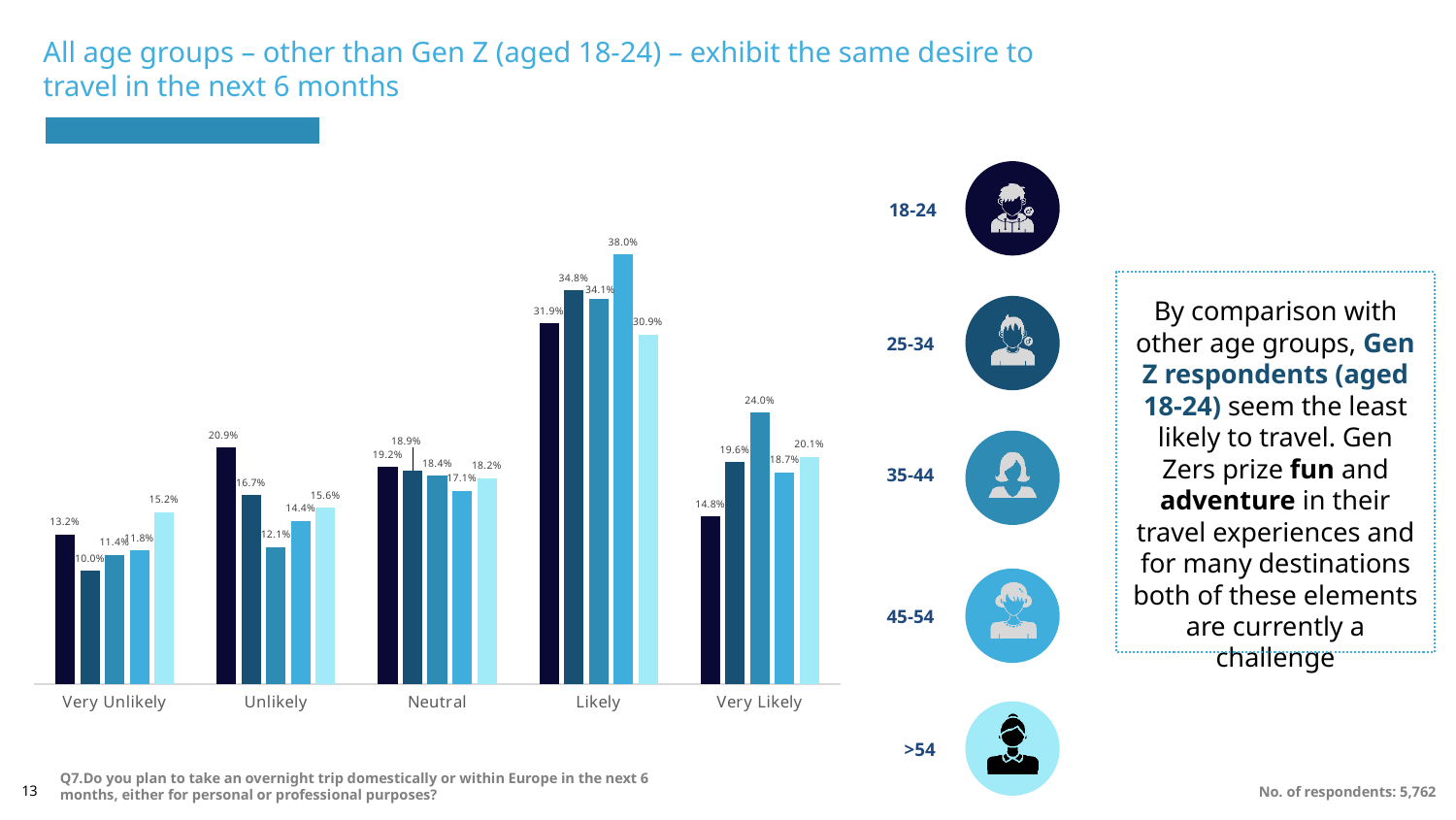
Which age group has the lowest value in the Very Likely category? 18-24 Which age group has the highest value in the Unlikely category? 18-24 What is the difference between the 45-54 and >54 values in the Likely category? 7.1% What is the value for the >54 age group in the Neutral category? 18.2% What is the value for the 35-44 age group in the Very Likely category? 24.0% How many response categories are shown on the x axis of the chart? 5 Which response category has the highest values across all age groups? Likely What kind of chart is shown on the slide? bar chart In the Very Unlikely category, which is larger: the value for 18-24 or the value for >54? >54 How many age groups (series) are listed in the legend on the right of the chart? 5 What is the value for the 18-24 age group in the Very Unlikely category? 13.2% What is the value for the 45-54 age group in the Likely category? 38.0%